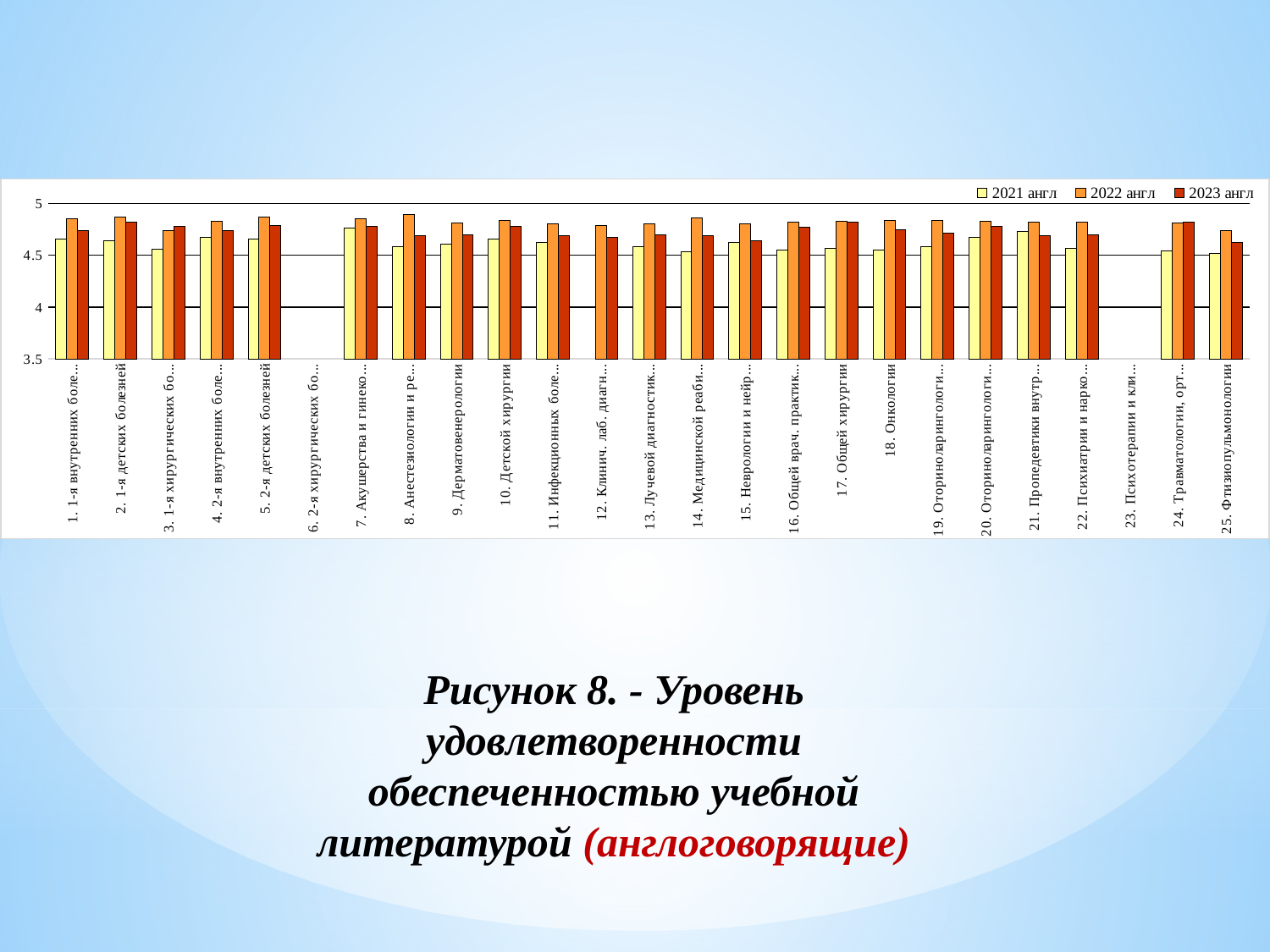
What kind of chart is shown on the slide? bar chart How many series does the legend list? 3 What are the series names listed in the legend? 2021 англ, 2022 англ, 2023 англ Is the 2023 англ value for "25. Фтизиопульмонологии" greater or less than 4? greater Is the 2021 англ value for "10. Детской хирургии" greater or less than 4.5? greater For "18. Онкологии", which is larger: the 2021 англ value or the 2023 англ value? 2023 англ For "9. Дерматовенерологии", which series has the lowest value? 2021 англ How many categories are labelled along the x axis? 25 What is the lowest value shown on the vertical axis? 3.5 For "17. Общей хирургии", which is larger: the 2021 англ value or the 2022 англ value? 2022 англ Is the 2022 англ value for "18. Онкологии" greater or less than 4.5? greater